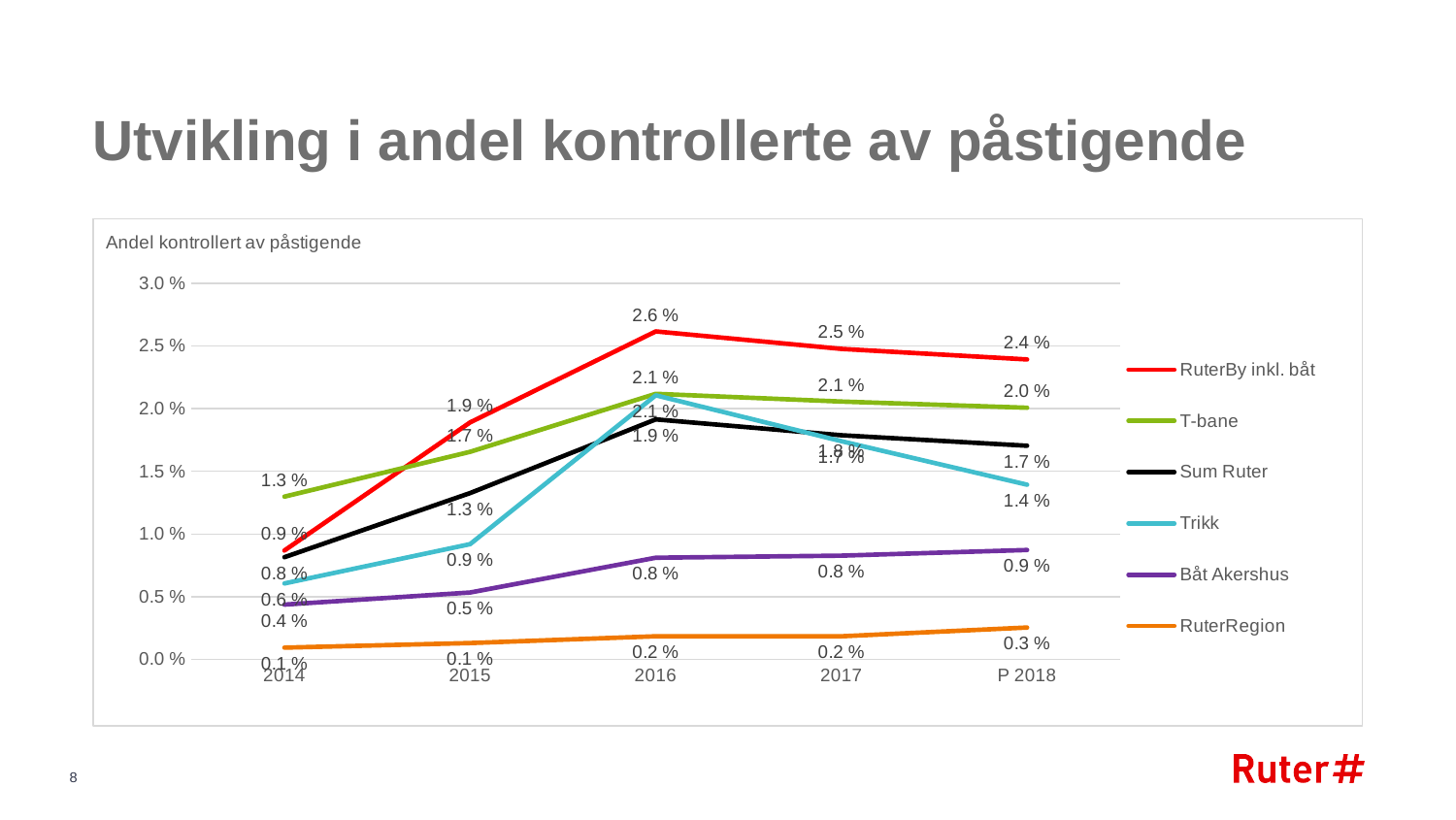
What is the title of the chart? Andel kontrollert av påstigende Does the Båt Akershus line rise or fall from 2014 to P 2018? rise Which series has the lowest value in 2016? RuterRegion What is the value for T-bane in P 2018? 2.0 % What is the value for RuterRegion in P 2018? 0.3 % How many series does the legend list? 6 In 2016, which is larger: T-bane or Sum Ruter? T-bane What is the value for RuterBy inkl. båt in 2016? 2.6 % How many years are shown on the x axis? 5 What kind of chart is shown on the slide? line chart In which year does RuterBy inkl. båt reach its highest value? 2016 What is the difference between the RuterBy inkl. båt values in 2016 and 2014? 1.7 %